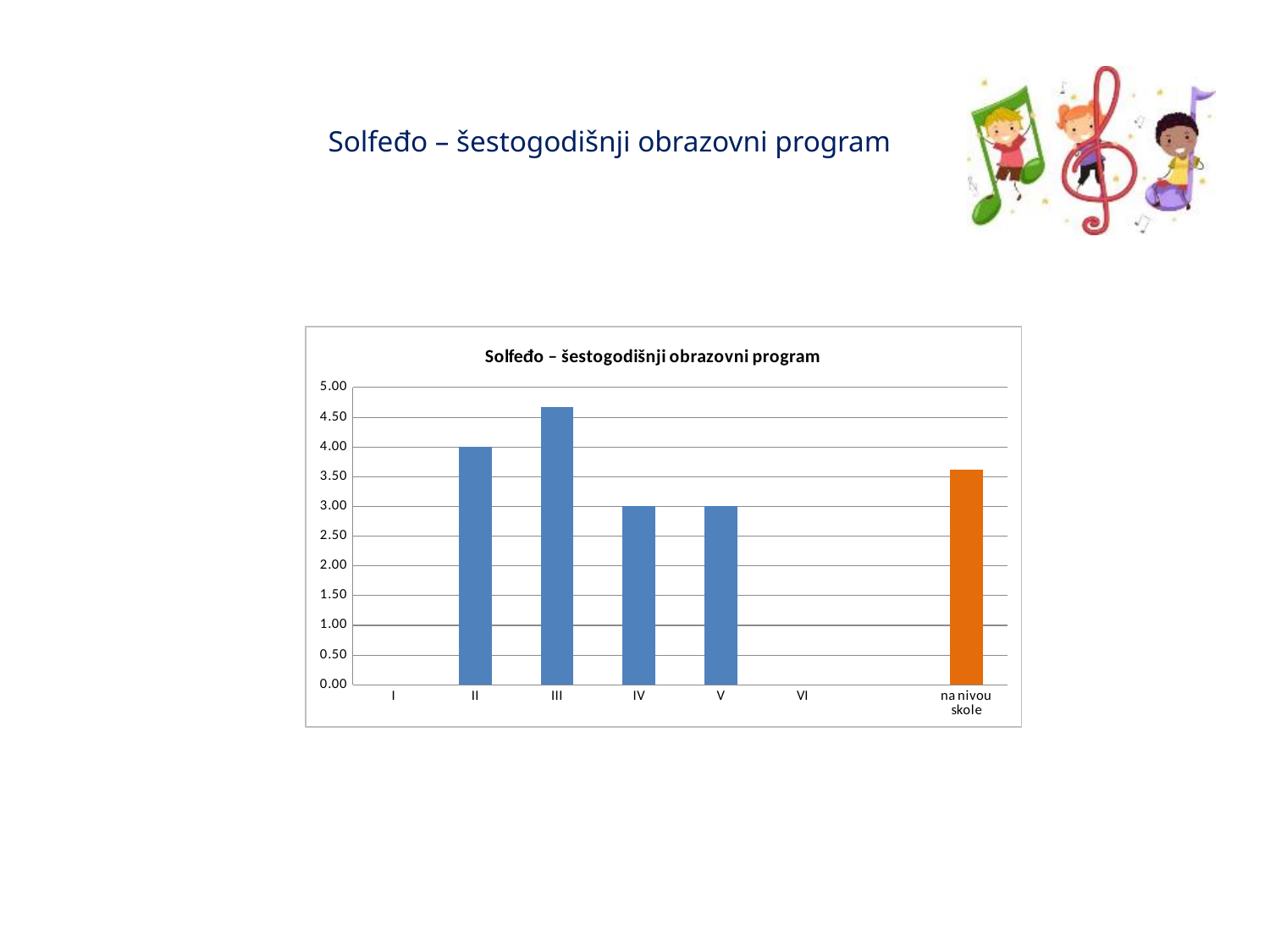
What is the value for category V? 3.00 What is the difference between the values for category II and category IV? 1.00 What is the value for category IV? 3.00 Is the value for 'na nivou skole' greater or less than 4.00? less Which bar is shown in a different colour (orange) from the others? na nivou skole What type of chart is shown on the slide? Bar chart What is the title of the chart? Solfeđo – šestogodišnji obrazovni program Is the value for 'na nivou skole' greater or less than 3.50? greater Is the value for category III greater or less than 4.50? greater Which category has the highest value? III What is the value for category II? 4.00 How many categories are shown on the x axis of the chart? 7